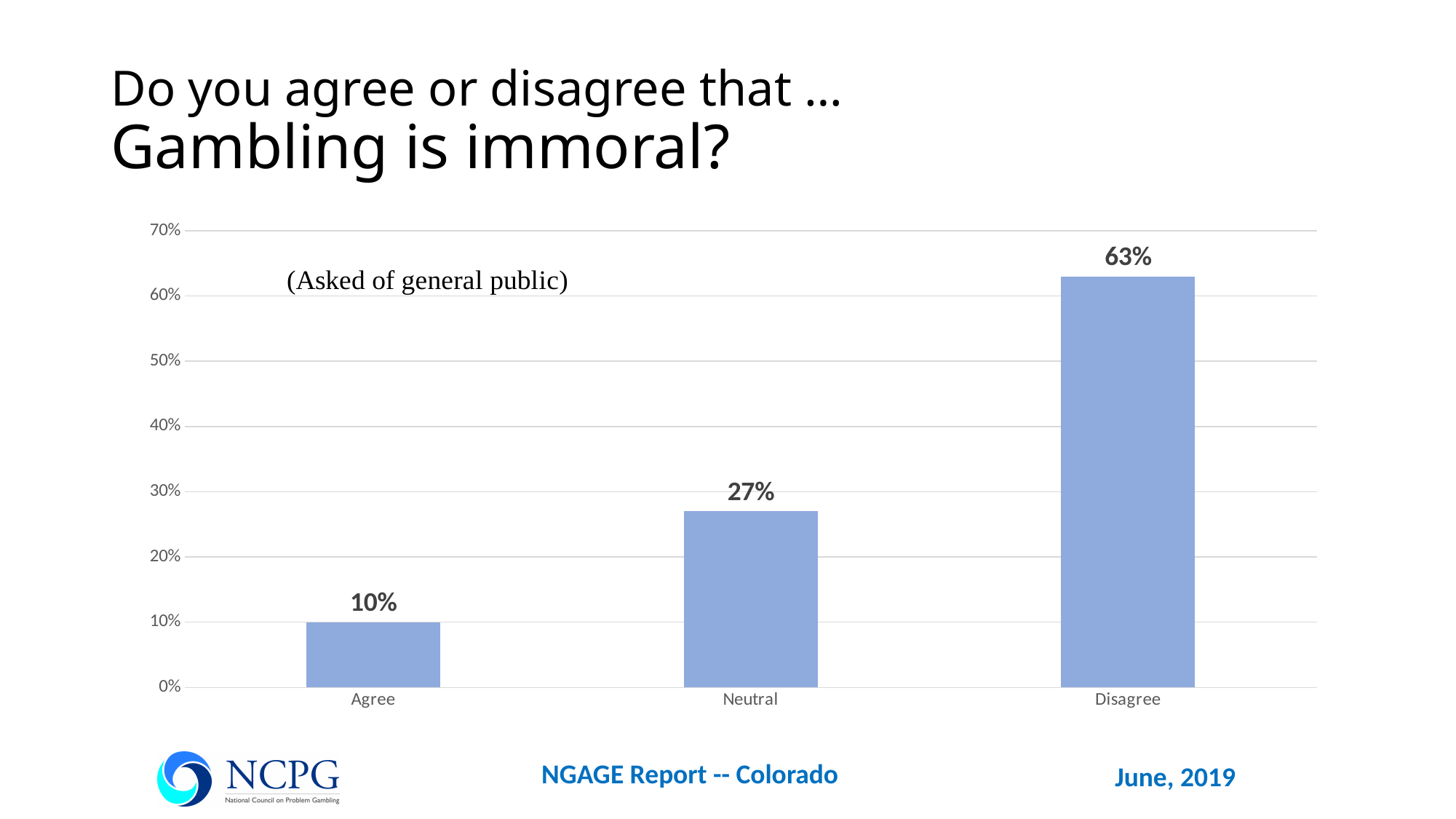
What kind of chart is shown on the slide? Bar chart Is the value for Disagree greater or less than 50%? greater What is the value shown for the Neutral category? 27% What percentage of respondents Disagree that gambling is immoral? 63% How many response categories are shown on the chart? 3 What is the difference between the Neutral and Agree values? 17% Do the values rise or fall moving from Agree to Disagree along the x axis? Rise Which response category has the lowest value? Agree What is the difference between the Disagree and Agree values? 53% Which is larger, the value for Neutral or the value for Agree? Neutral What percentage of respondents said they Agree that gambling is immoral? 10% Which response category has the highest value? Disagree